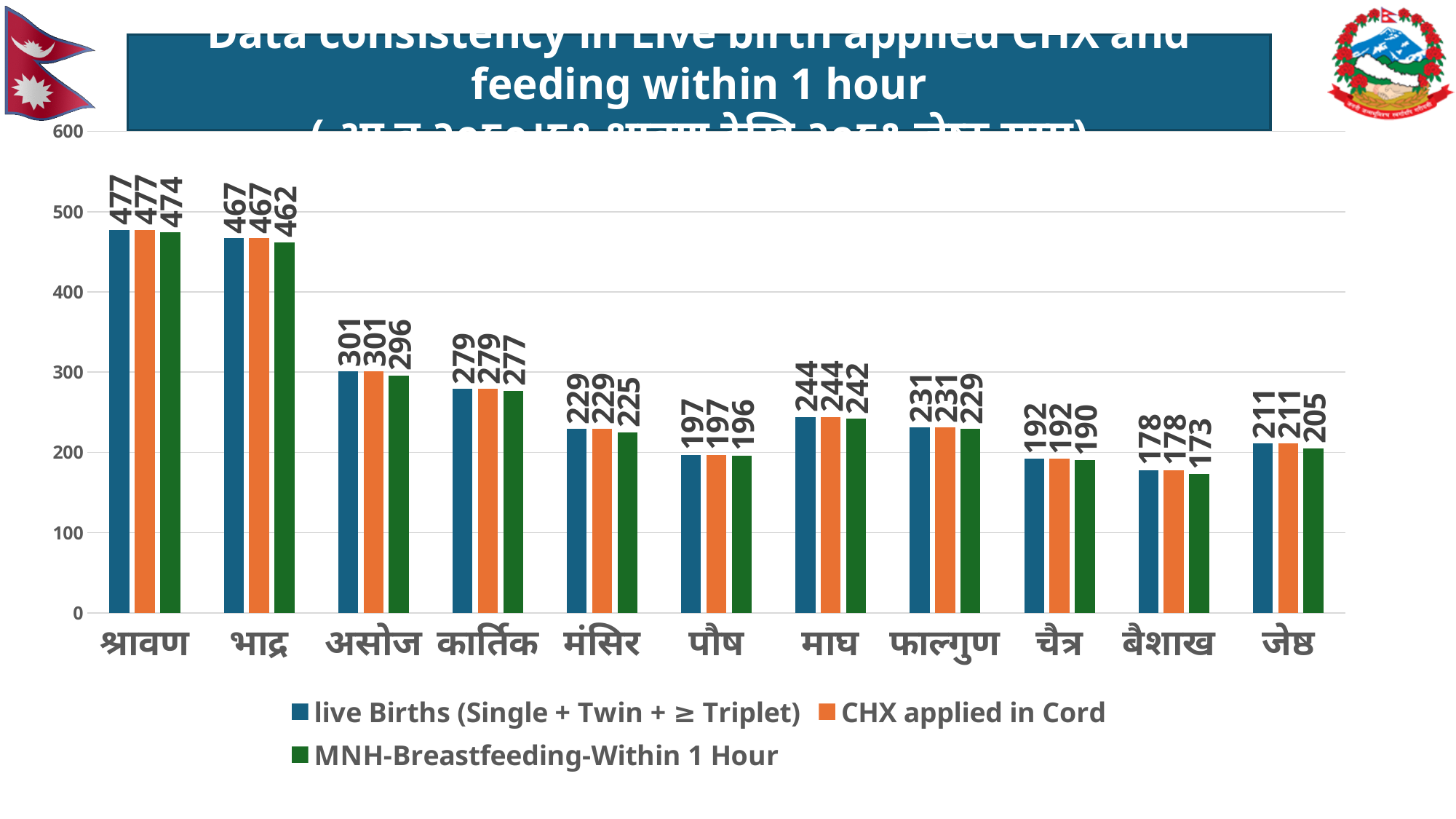
What is the value of CHX applied in Cord for असोज? 301 Which is larger, the live Births value for माघ or for फाल्गुण? माघ What is the value of MNH-Breastfeeding-Within 1 Hour for भाद्र? 462 Which month has the highest value for MNH-Breastfeeding-Within 1 Hour? श्रावण How many months are shown on the x axis? 11 How many series does the legend list? 3 What is the difference between CHX applied in Cord and MNH-Breastfeeding-Within 1 Hour for बैशाख? 5 Which month has the lowest value for live Births (Single + Twin + ≥ Triplet)? बैशाख What kind of chart is shown on the slide? bar chart What is the value of live Births (Single + Twin + ≥ Triplet) for श्रावण? 477 Is the value of CHX applied in Cord for कार्तिक greater or less than 300? less What is the difference between live Births and MNH-Breastfeeding-Within 1 Hour for जेष्ठ? 6